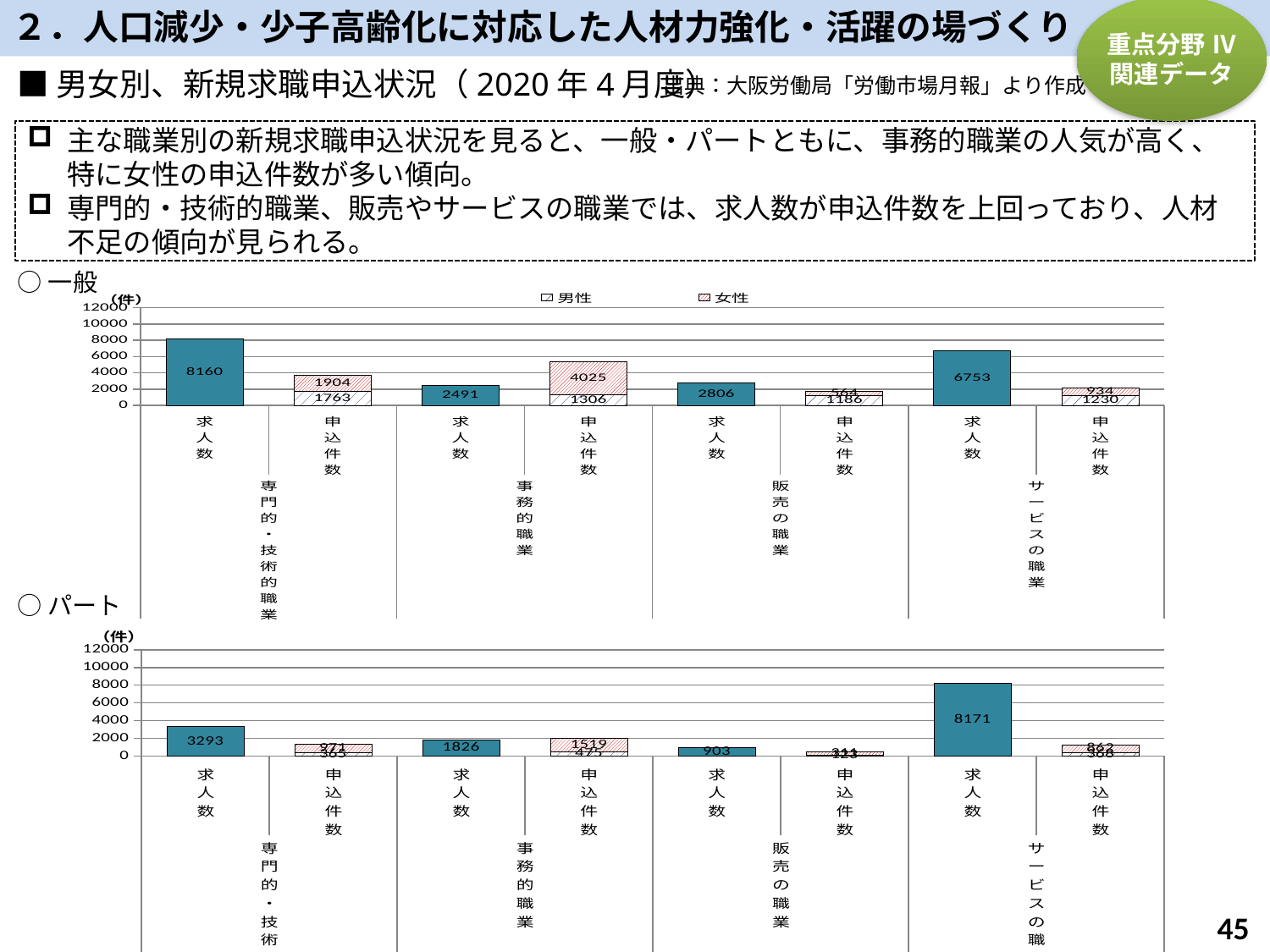
In the top chart (一般), which occupation has the highest 求人数? 専門的・技術的職業 In the bottom chart (パート), what is the difference between the 求人数 for サービスの職業 and the 求人数 for 専門的・技術的職業? 4878 How many series does the legend of the top chart (一般) list? 2 In the top chart (一般), what is the 男性 申込件数 value for 事務的職業? 1306 In the top chart (一般), what is the 求人数 value for 専門的・技術的職業? 8160 What kind of chart is the bottom chart (パート)? Stacked bar chart In the bottom chart (パート), which occupation has the lowest 求人数? 販売の職業 In the top chart (一般), what is the total 申込件数 (男性 plus 女性) for 事務的職業? 5331 In the bottom chart (パート), what is the 求人数 value for サービスの職業? 8171 In the top chart (一般), which is larger, the 求人数 for 事務的職業 or for 販売の職業? 販売の職業 In the top chart (一般), what is the 女性 申込件数 value for 事務的職業? 4025 In the top chart (一般), what is the 求人数 value for サービスの職業? 6753